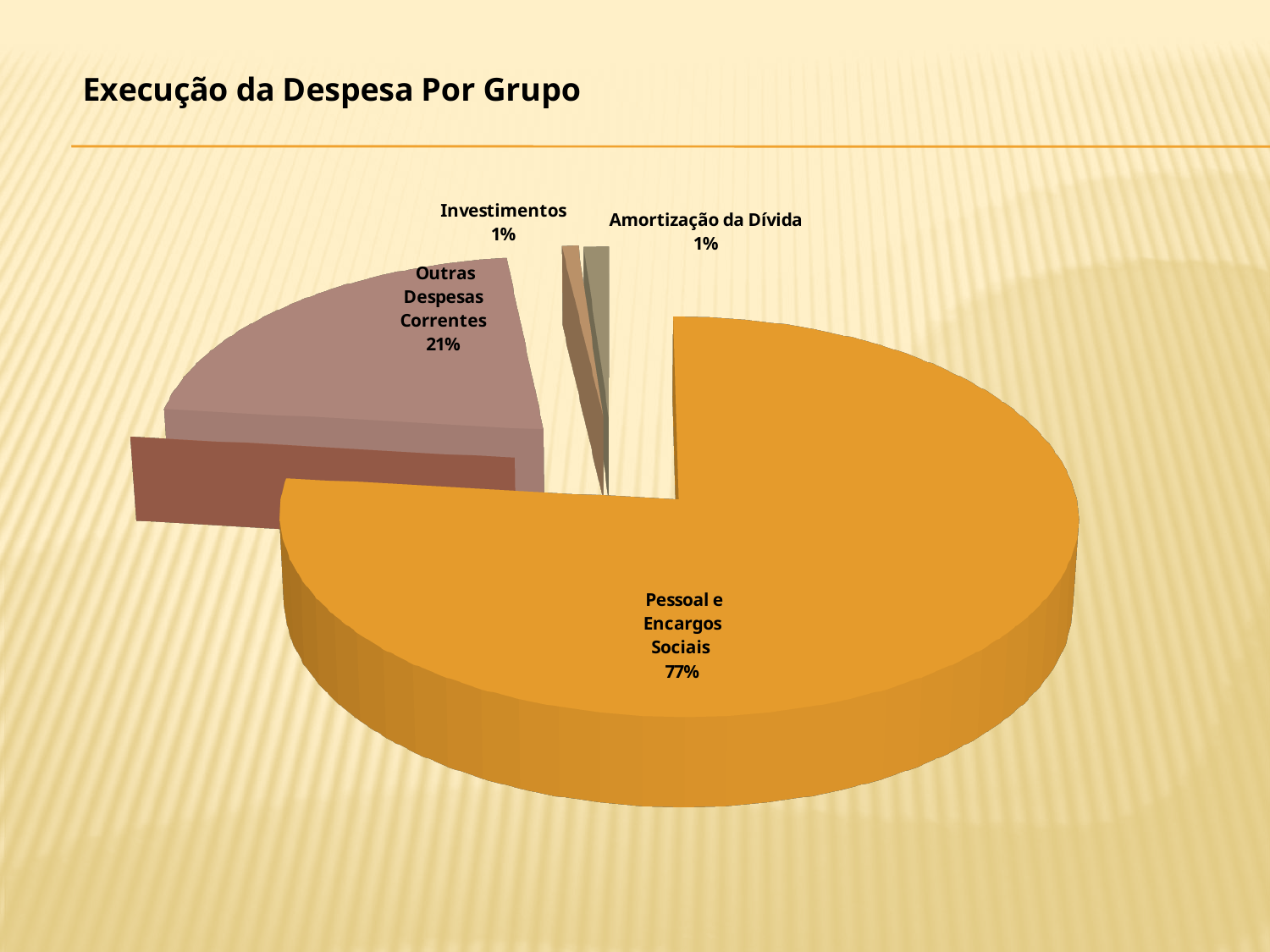
What is the value shown for Amortização da Dívida? 1% Which is larger, Outras Despesas Correntes or Investimentos? Outras Despesas Correntes What is the difference in percentage points between Pessoal e Encargos Sociais and Outras Despesas Correntes? 56 What kind of chart is shown on the slide? pie chart What is the value shown for Investimentos? 1% Which category has the largest slice of the pie? Pessoal e Encargos Sociais What share of the pie does Pessoal e Encargos Sociais represent? 77% How many slices does the pie chart have? 4 What colour is the slice for Pessoal e Encargos Sociais? orange What share of the pie does Outras Despesas Correntes represent? 21% What is the title of the slide? Execução da Despesa Por Grupo